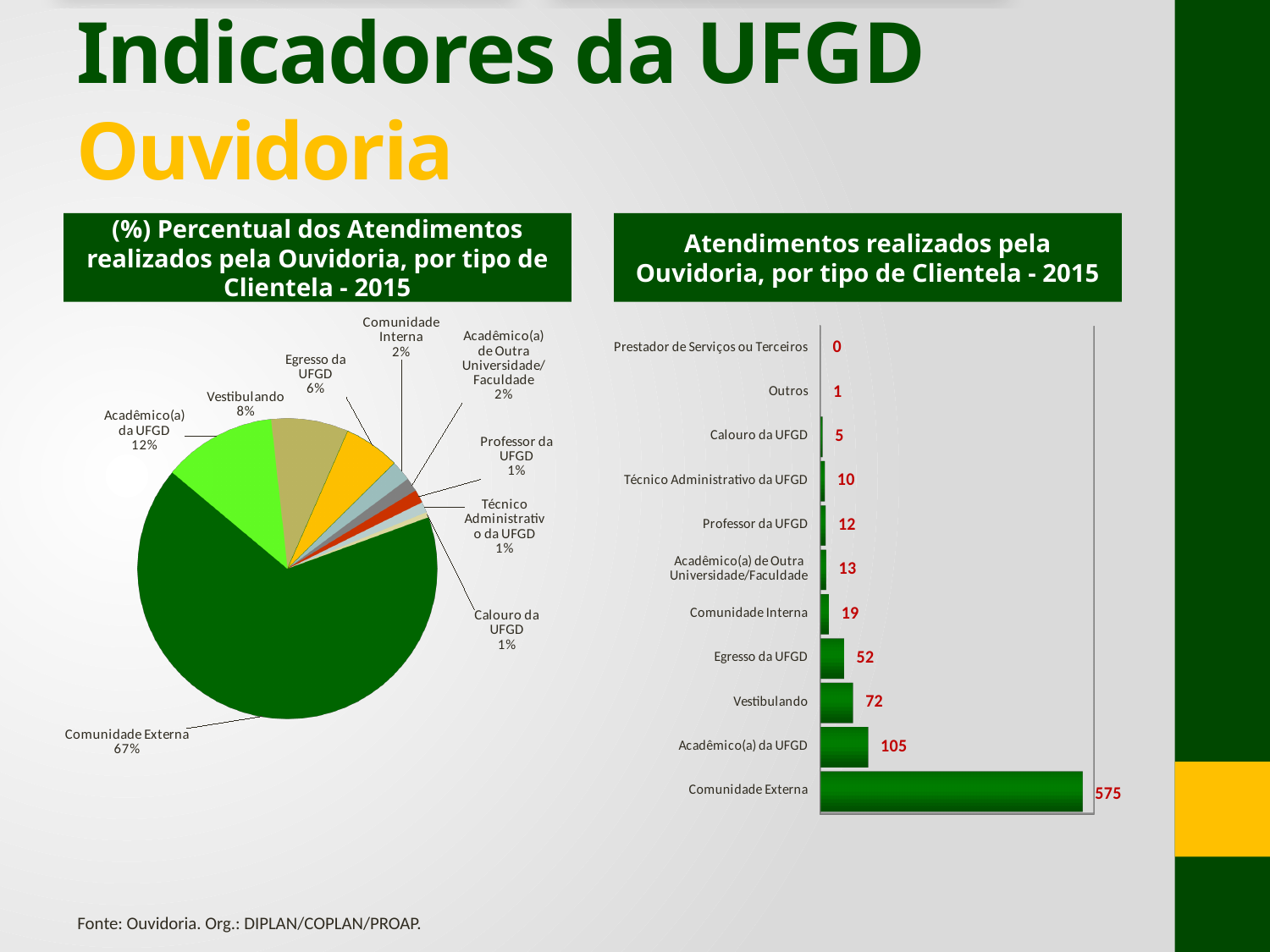
In the pie chart '(%) Percentual dos Atendimentos realizados pela Ouvidoria, por tipo de Clientela - 2015', what is the percentage for Egresso da UFGD? 6% How many categories are shown in the bar chart 'Atendimentos realizados pela Ouvidoria, por tipo de Clientela - 2015'? 11 In the pie chart '(%) Percentual dos Atendimentos realizados pela Ouvidoria, por tipo de Clientela - 2015', which category has the largest slice? Comunidade Externa In the bar chart 'Atendimentos realizados pela Ouvidoria, por tipo de Clientela - 2015', what is the value for Comunidade Externa? 575 What kind of chart is the chart on the left of the slide? Pie chart What kind of chart is the chart on the right of the slide? Bar chart In the pie chart '(%) Percentual dos Atendimentos realizados pela Ouvidoria, por tipo de Clientela - 2015', what share does Comunidade Externa have? 67% In the bar chart 'Atendimentos realizados pela Ouvidoria, por tipo de Clientela - 2015', what is the value for Vestibulando? 72 In the bar chart 'Atendimentos realizados pela Ouvidoria, por tipo de Clientela - 2015', which category has the lowest value? Prestador de Serviços ou Terceiros In the bar chart 'Atendimentos realizados pela Ouvidoria, por tipo de Clientela - 2015', what is the value for Técnico Administrativo da UFGD? 10 In the bar chart 'Atendimentos realizados pela Ouvidoria, por tipo de Clientela - 2015', what is the difference between Acadêmico(a) da UFGD and Egresso da UFGD? 53 In the bar chart 'Atendimentos realizados pela Ouvidoria, por tipo de Clientela - 2015', which is larger: Comunidade Interna or Professor da UFGD? Comunidade Interna